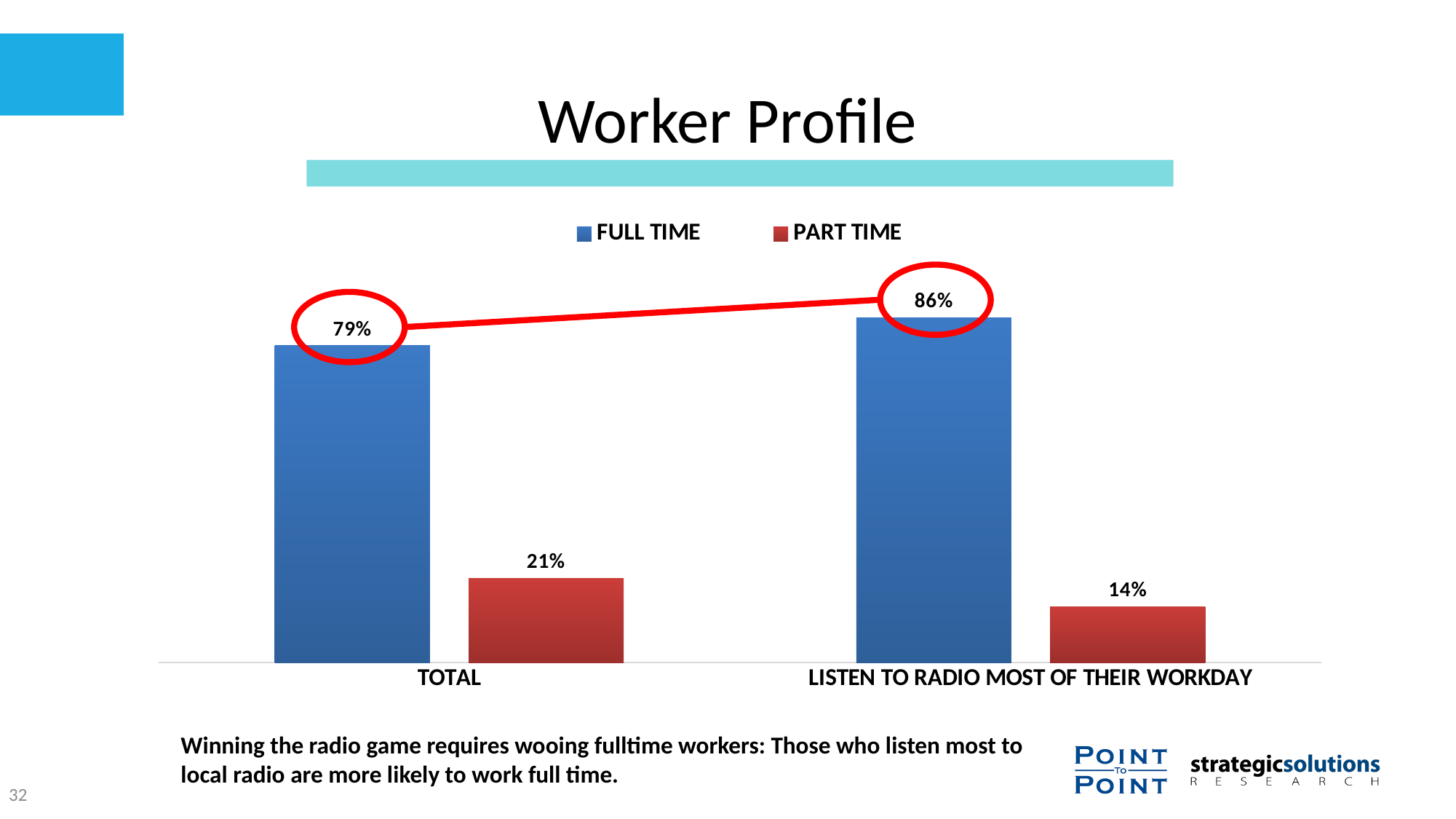
Which is larger: the FULL TIME value for TOTAL or the FULL TIME value for LISTEN TO RADIO MOST OF THEIR WORKDAY? LISTEN TO RADIO MOST OF THEIR WORKDAY What kind of chart is shown on the slide? Bar chart What is the FULL TIME value for TOTAL? 79% What is the difference between the PART TIME values for TOTAL and LISTEN TO RADIO MOST OF THEIR WORKDAY? 7% Which category has the highest FULL TIME value? LISTEN TO RADIO MOST OF THEIR WORKDAY What is the FULL TIME value for LISTEN TO RADIO MOST OF THEIR WORKDAY? 86% What is the PART TIME value for TOTAL? 21% How many series does the legend list? 2 What is the difference between the FULL TIME values for LISTEN TO RADIO MOST OF THEIR WORKDAY and TOTAL? 7% What is the PART TIME value for LISTEN TO RADIO MOST OF THEIR WORKDAY? 14% How many categories are shown on the x axis? 2 Which category has the lowest PART TIME value? LISTEN TO RADIO MOST OF THEIR WORKDAY